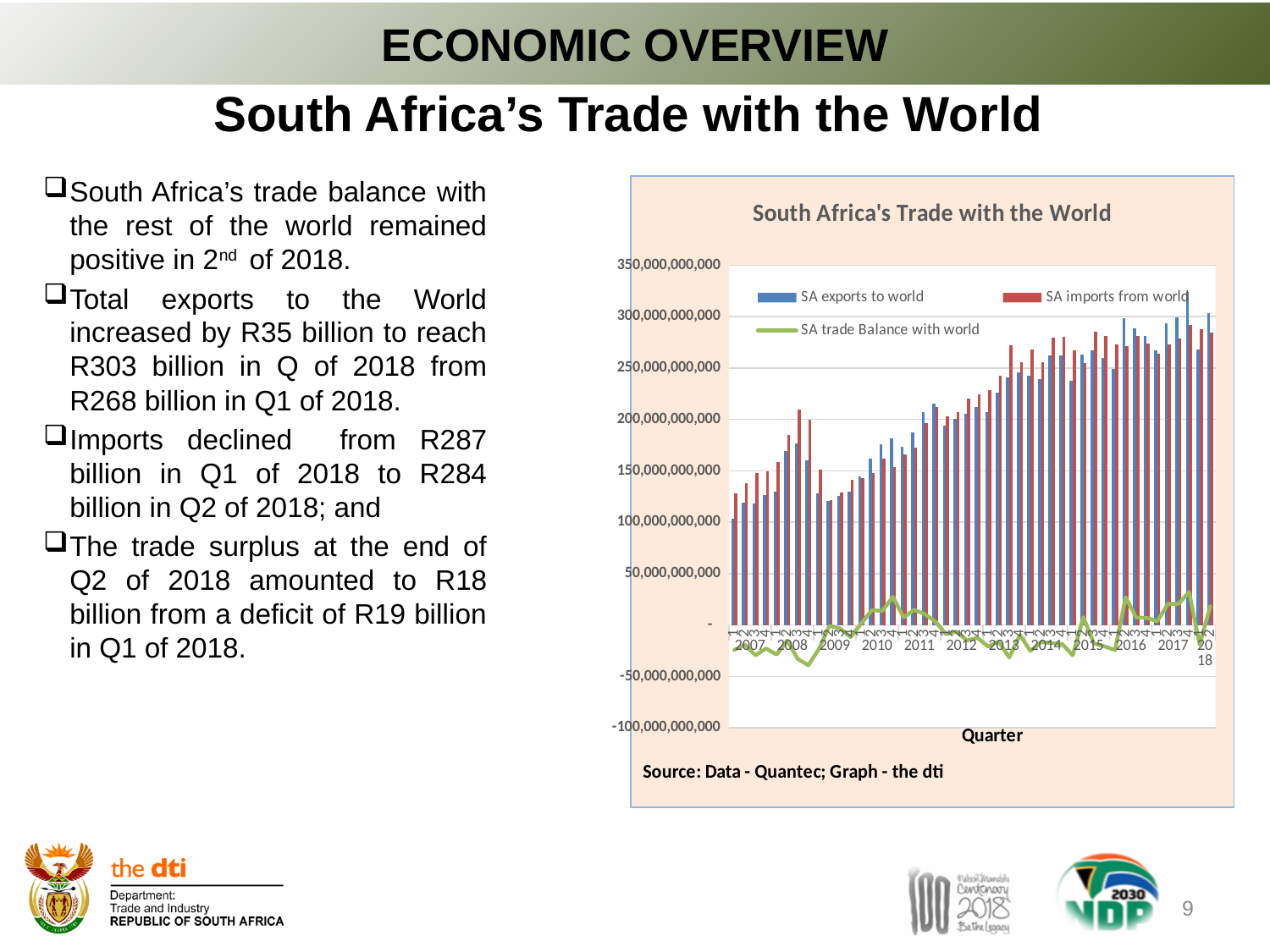
What kind of chart is used for the exports and imports series in 'South Africa's Trade with the World'? Bar chart Do the SA exports to world bars generally rise or fall from 2007 to 2018? rise How many years are labelled along the x axis of the chart? 12 Is the value of SA imports from world in Q1 of 2009 greater or less than 200,000,000,000? less How many series does the legend of the chart list? 3 Which year has the lowest SA exports to world bars in the chart? 2007 Which series in the chart is drawn as a line rather than bars? SA trade Balance with world Is the value of SA exports to world in Q1 of 2007 greater or less than 150,000,000,000? less Is the value of SA exports to world in Q2 of 2018 greater or less than 250,000,000,000? greater What is the title of the chart's horizontal axis? Quarter Which is larger: SA imports from world in 2009 or in 2014? 2014